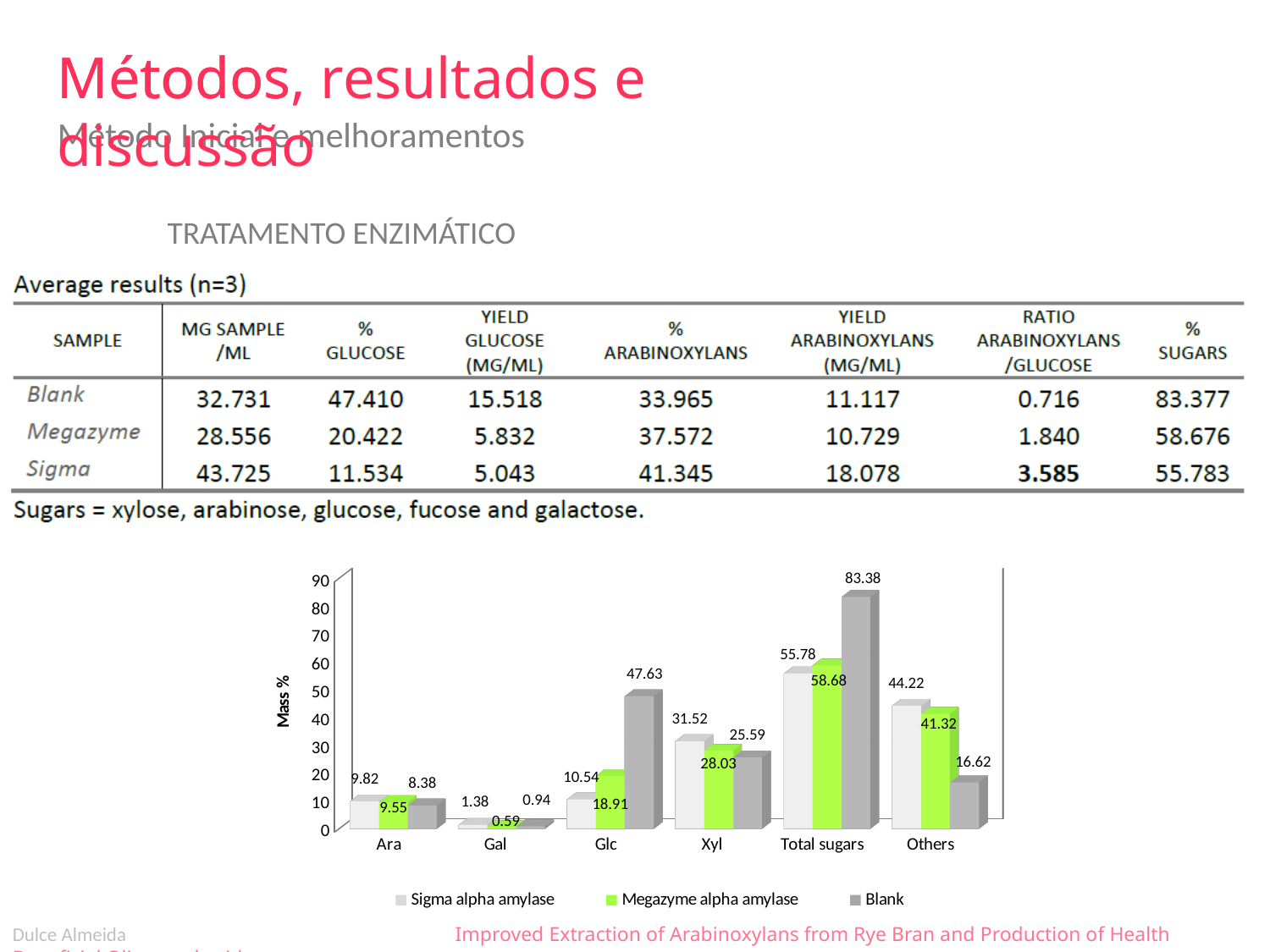
What is the Sigma alpha amylase value for Xyl in the chart? 31.52 For Others, which is larger in the chart: the Sigma alpha amylase value or the Blank value? Sigma alpha amylase Which series is shown in green in the chart? Megazyme alpha amylase Which category has the lowest Sigma alpha amylase value in the chart? Gal What is the Blank value for Glc in the chart? 47.63 What is the difference between the Blank and Sigma alpha amylase values for Total sugars in the chart? 27.60 How many series does the chart legend list? 3 How many categories are shown on the x axis of the chart? 6 What is the Megazyme alpha amylase value for Total sugars in the chart? 58.68 What is the y-axis label of the chart? Mass % Which category has the highest Blank value in the chart? Total sugars What type of chart is shown on the slide? bar chart